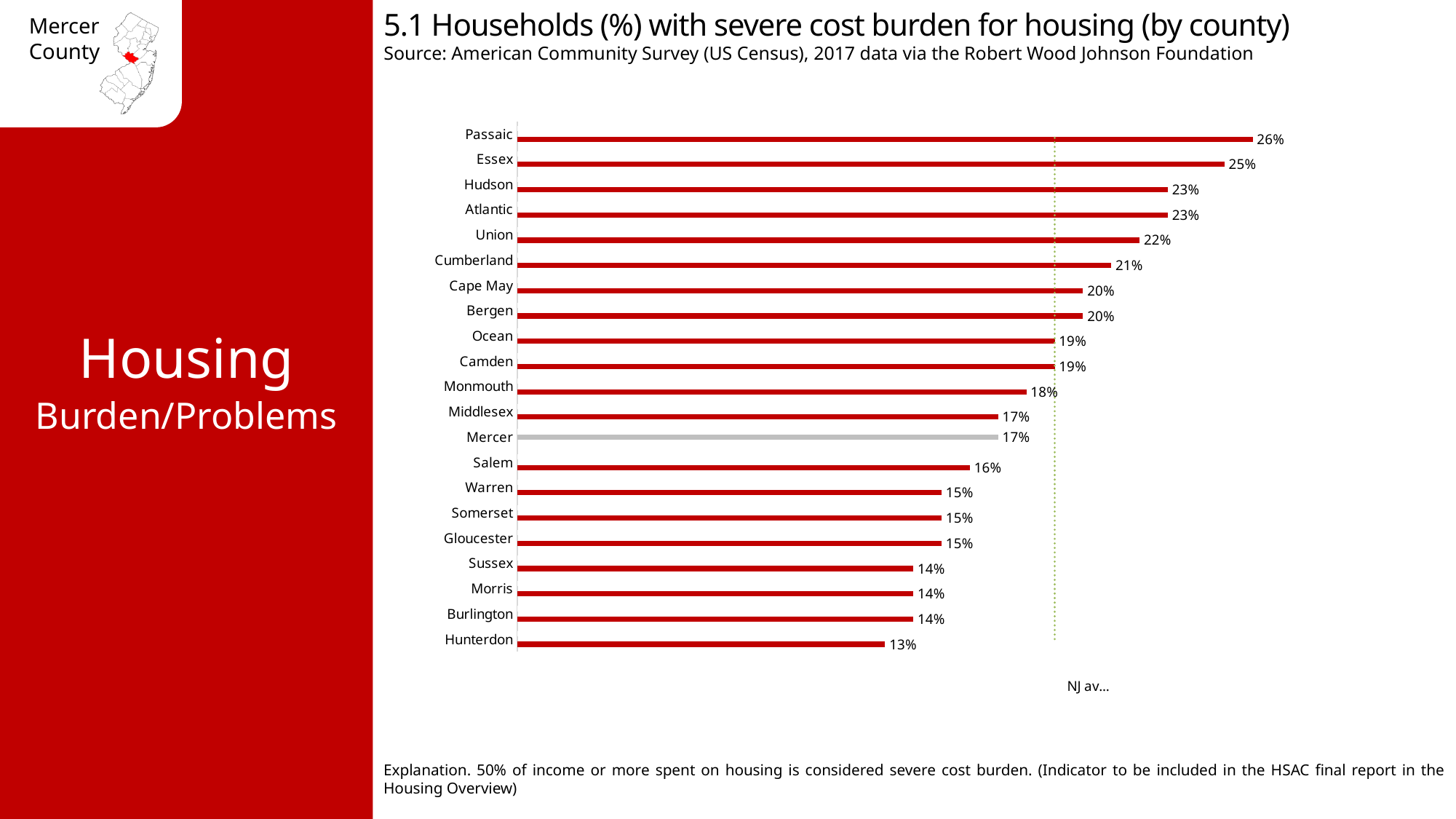
What type of chart is used on this slide? Bar chart How many counties are shown in the chart? 21 Which county has the highest percentage of households with severe cost burden? Passaic Which has a higher value, Union or Salem? Union What percentage of households in Mercer County have a severe housing cost burden? 17% What is the value shown for Cumberland? 21% What is the difference in percentage points between Passaic and Mercer? 9 Which county has the lowest percentage of households with severe cost burden? Hunterdon What is the difference in percentage points between Essex and Hunterdon? 12 What is the value shown for Hunterdon? 13% What is the value shown for Passaic? 26% Which county's bar is shown in gray instead of red? Mercer